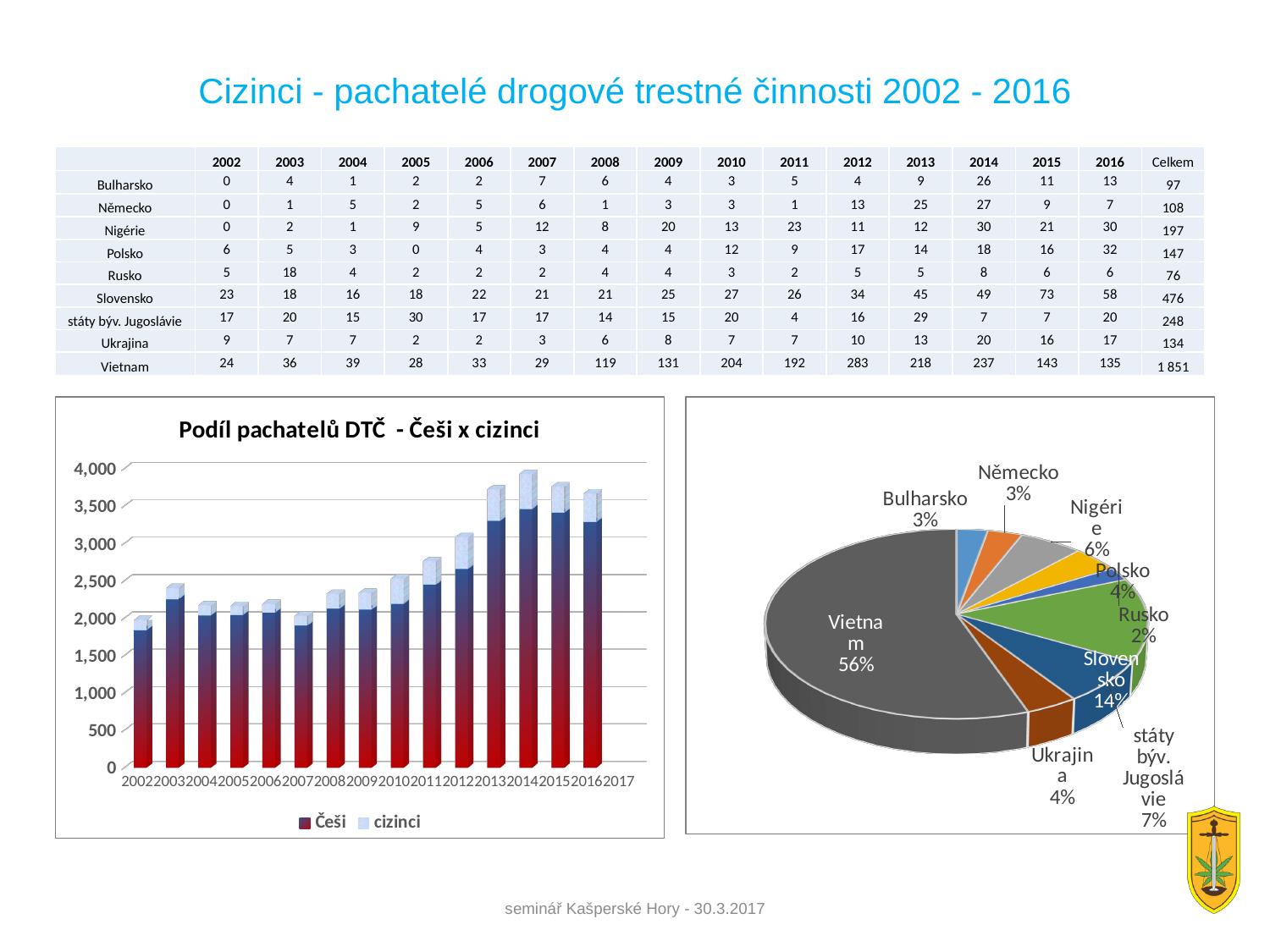
In 'Podíl pachatelů DTČ - Češi x cizinci', is the total bar height for 2014 greater or less than 3,500? greater In the pie chart on the right, which country has the smallest slice? Rusko What kind of chart is 'Podíl pachatelů DTČ - Češi x cizinci'? Stacked bar chart How many years are shown on the x axis of 'Podíl pachatelů DTČ - Češi x cizinci'? 16 In the pie chart on the right, what share does Vietnam have? 56% In the pie chart on the right, what share does Slovensko have? 14% In the pie chart on the right, which is larger, the share for Nigérie or the share for Polsko? Nigérie In the pie chart on the right, how many slices are there? 9 In 'Podíl pachatelů DTČ - Češi x cizinci', which year has the tallest stacked bar? 2014 In the pie chart on the right, what is the difference in percentage points between the Vietnam share and the Slovensko share? 42 In the pie chart on the right, which country has the largest slice? Vietnam How many series does the legend of 'Podíl pachatelů DTČ - Češi x cizinci' list? 2